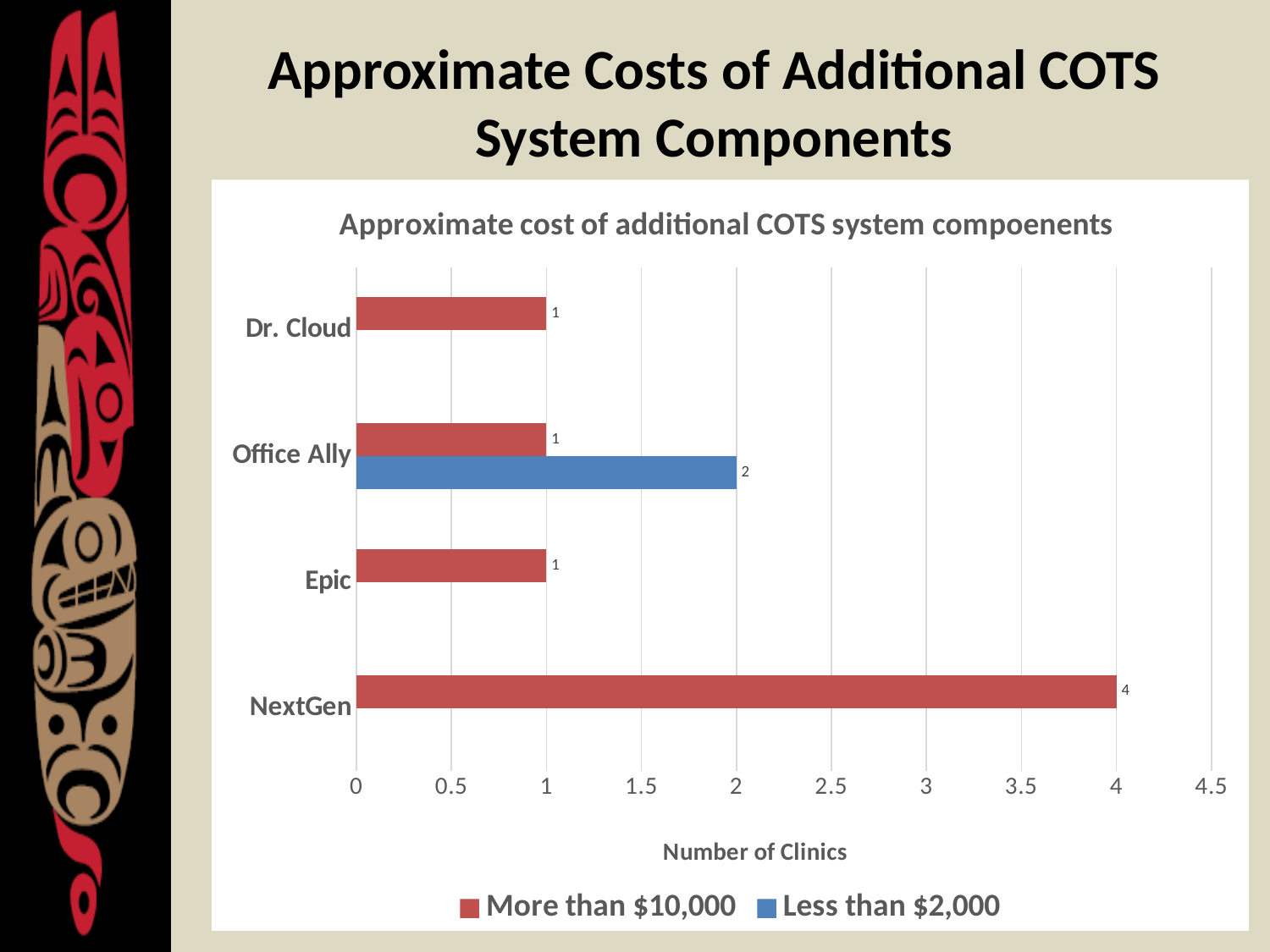
What is the value for Office Ally in the 'Less than $2,000' series? 2 Which category has the highest value in the 'More than $10,000' series? NextGen What is the value for NextGen in the 'More than $10,000' series? 4 What is the title of the x axis? Number of Clinics How many categories (systems) are shown on the y axis? 4 How many series does the legend list? 2 What type of chart is shown on the slide? bar chart Which category is the only one with a bar in the 'Less than $2,000' series? Office Ally What is the value for Epic in the 'More than $10,000' series? 1 What is the difference between the NextGen and Dr. Cloud values in the 'More than $10,000' series? 3 For Office Ally, which is larger: the 'More than $10,000' value or the 'Less than $2,000' value? Less than $2,000 Is the value for NextGen in the 'More than $10,000' series greater or less than 3? greater